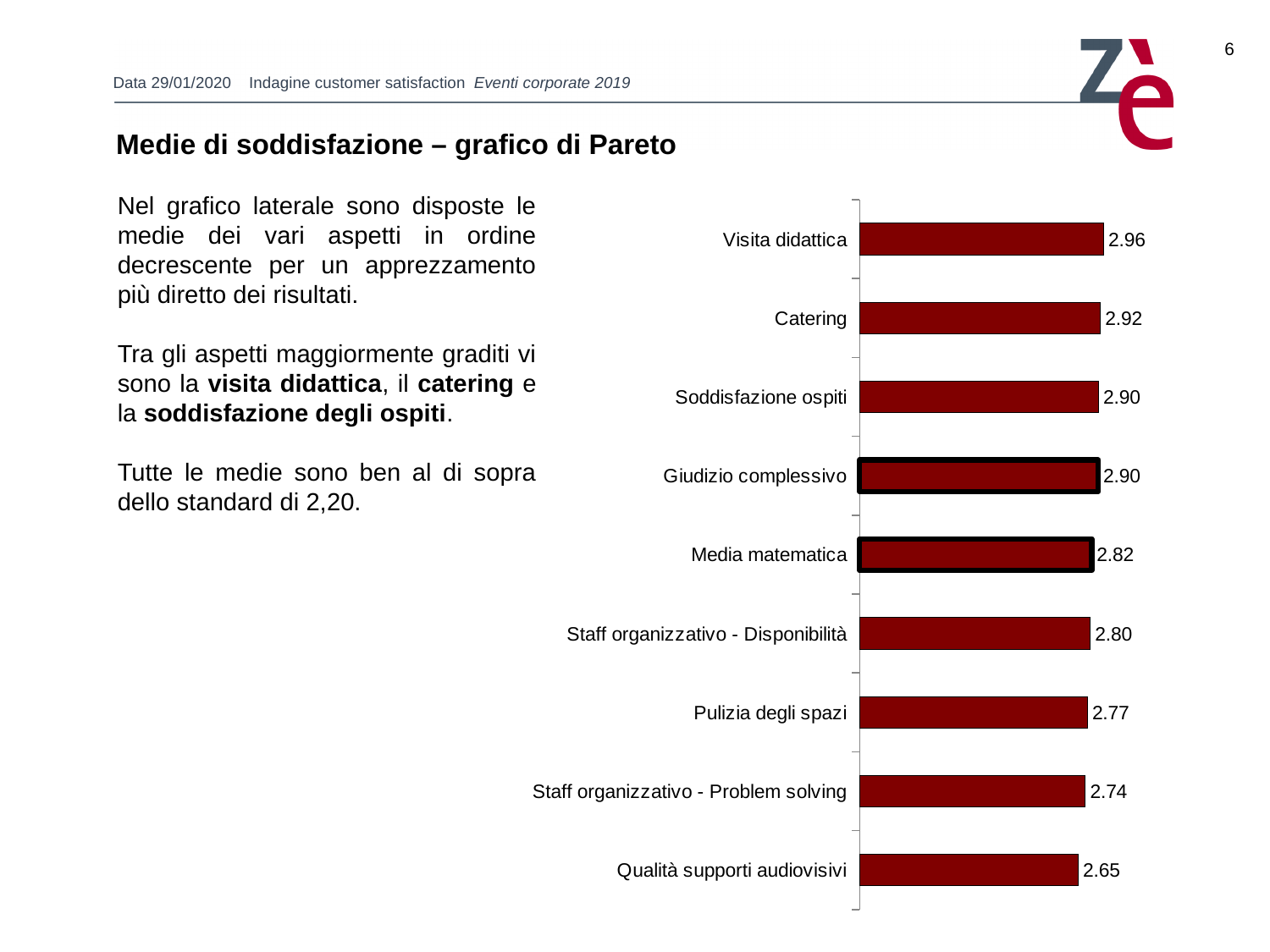
What is the difference between the values for Visita didattica and Qualità supporti audiovisivi? 0.31 What is the value for Visita didattica? 2.96 What is the value for Staff organizzativo - Problem solving? 2.74 What kind of chart is shown on the slide? Bar chart What is the value for Catering? 2.92 What is the value for Qualità supporti audiovisivi? 2.65 How many categories are shown in the chart? 9 What is the difference between the values for Catering and Pulizia degli spazi? 0.15 Which category has the highest value? Visita didattica Which two bars are drawn with a thick black outline? Giudizio complessivo and Media matematica Which is larger, the value for Staff organizzativo - Disponibilità or the value for Staff organizzativo - Problem solving? Staff organizzativo - Disponibilità Which category has the lowest value? Qualità supporti audiovisivi